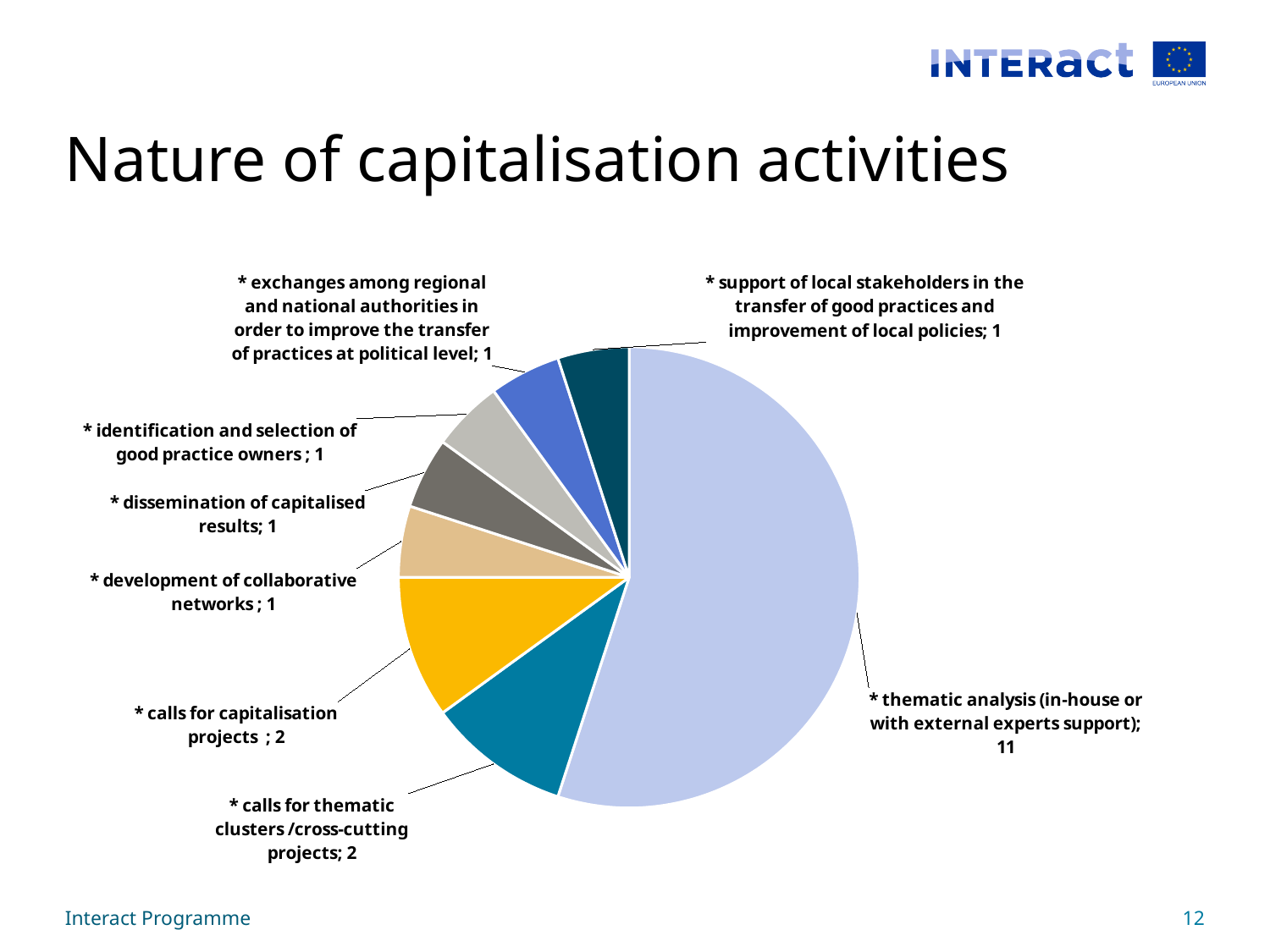
What type of chart is shown on the slide? pie chart What is the value for calls for thematic clusters / cross-cutting projects? 2 Which category has the largest slice of the pie? thematic analysis (in-house or with external experts support) What is the title of the slide containing the pie chart? Nature of capitalisation activities What is the difference between the value for thematic analysis and the value for calls for capitalisation projects? 9 What is the value for thematic analysis (in-house or with external experts support)? 11 What share of the pie does thematic analysis (in-house or with external experts support) represent? 55% How many slices does the pie chart have? 8 Which is larger: the value for calls for capitalisation projects or the value for dissemination of capitalised results? calls for capitalisation projects What is the value for development of collaborative networks? 1 What share of the pie does calls for thematic clusters / cross-cutting projects represent? 10% What is the total of all the values in the pie chart? 20